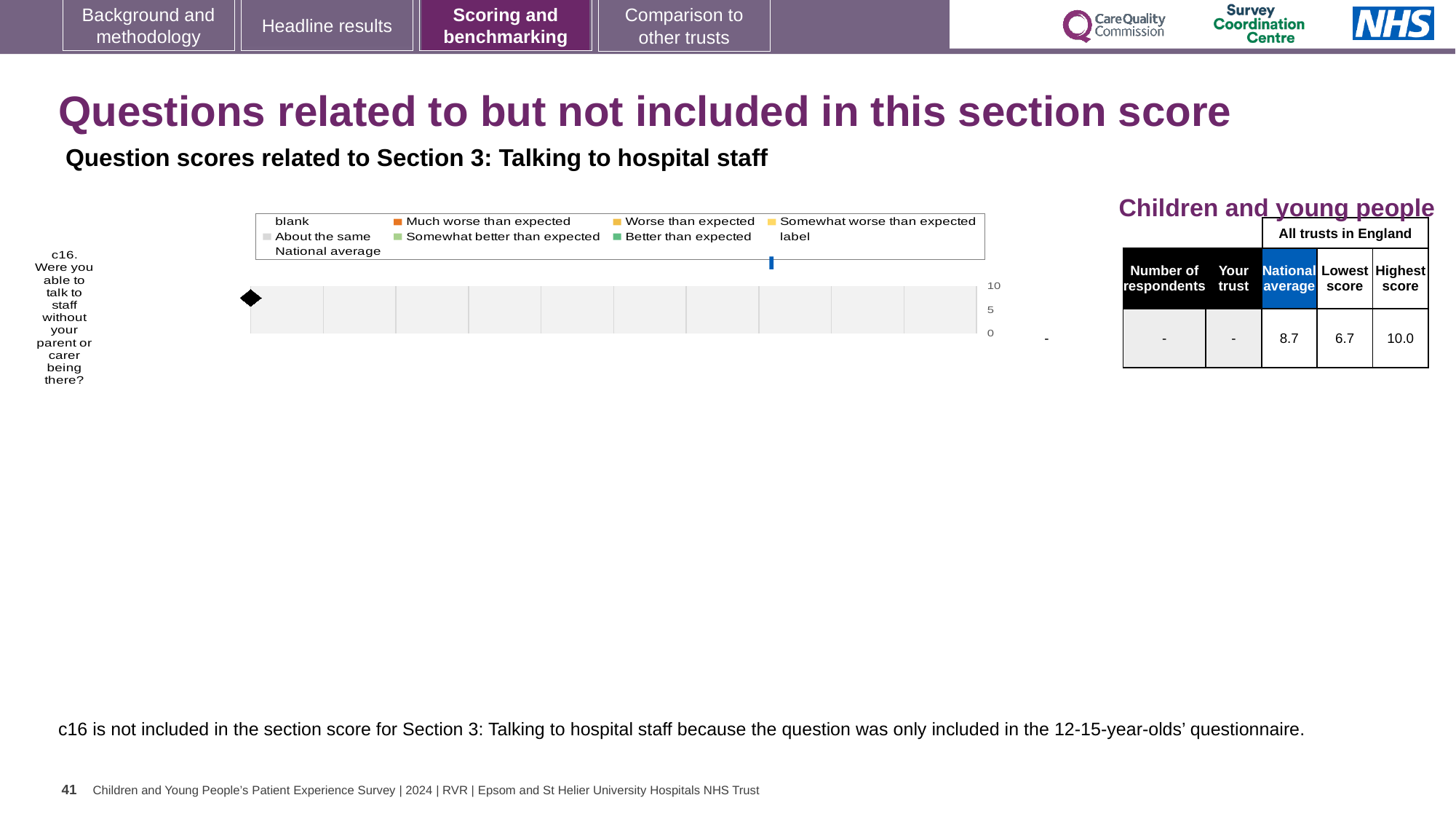
What is the maximum value shown on the chart's score axis? 10 In the table next to the chart, what is shown for 'Your trust' for c16? - In the table next to the chart, what is the highest score among all trusts in England for c16? 10.0 What kind of chart is shown on the slide? bar chart In the table next to the chart, what is the national average score for c16? 8.7 Which survey question is shown on the chart's category axis? c16. Were you able to talk to staff without your parent or carer being there? What is the difference between the highest score and the lowest score for c16 in the table? 3.3 Is the national average score for c16 greater or less than 5? greater Which is larger for c16: the national average or the lowest score? National average How many survey questions are plotted on the chart? 1 In the table next to the chart, what is the lowest score among all trusts in England for c16? 6.7